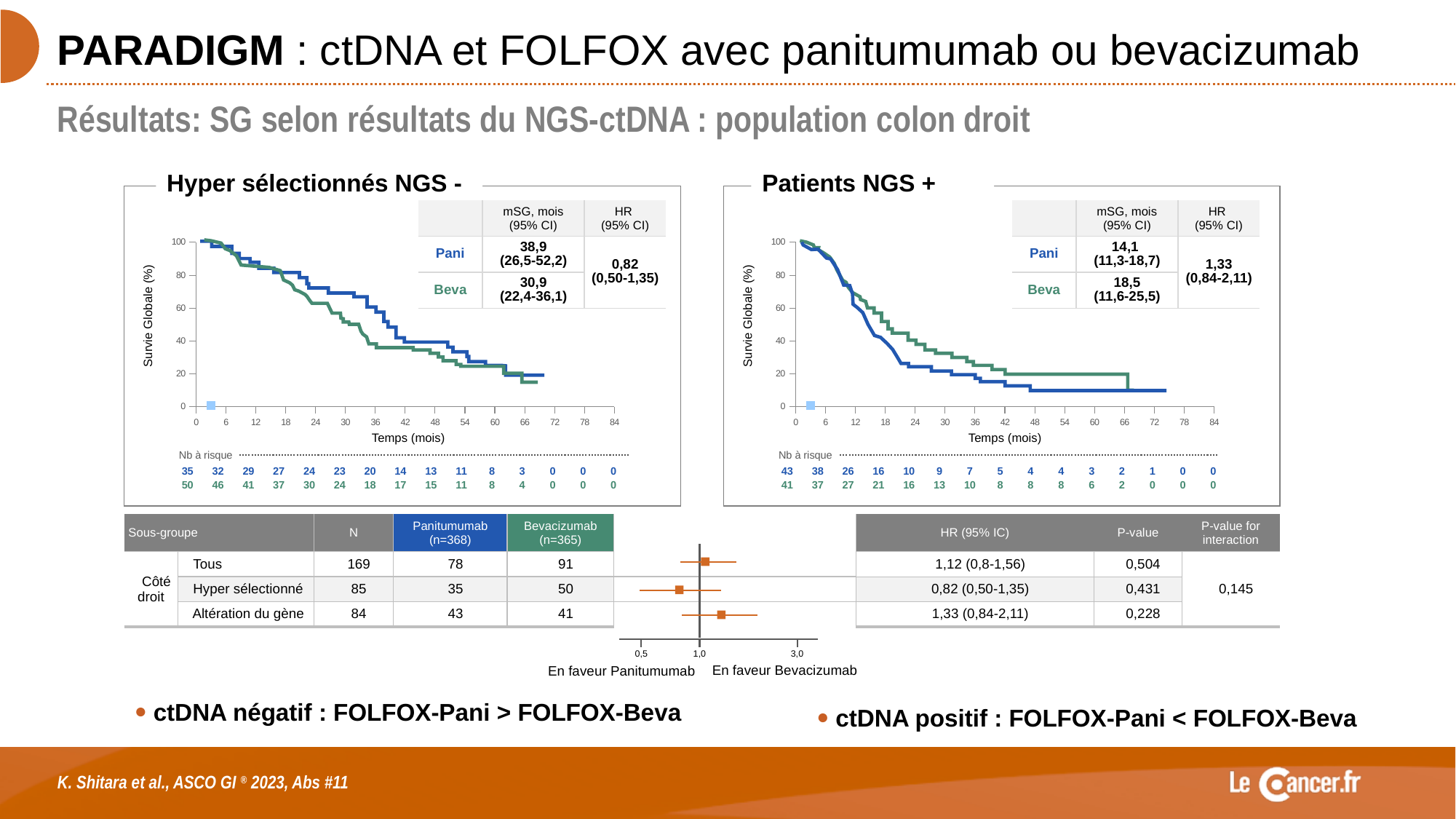
In the 'Patients NGS +' chart, what is the difference in median overall survival between Beva and Pani? 4,4 mois In the 'Hyper sélectionnés NGS -' chart, how many Pani patients are at risk at 0 months? 35 What is the x-axis label of the two survival charts? Temps (mois) In the forest plot at the bottom, how many subgroups are plotted? 3 In the 'Patients NGS +' chart, what is the median overall survival (mSG) for Beva? 18,5 mois In the 'Patients NGS +' chart, what is the HR (95% CI)? 1,33 (0,84-2,11) What kind of chart are the two upper charts on the slide? Kaplan-Meier survival curves In the 'Hyper sélectionnés NGS -' chart, which arm has the higher median overall survival, Pani or Beva? Pani In the 'Patients NGS +' chart, how many Beva patients are at risk at 24 months? 16 In the 'Hyper sélectionnés NGS -' chart, what is the median overall survival (mSG) for Pani? 38,9 mois In the forest plot table at the bottom, what is the HR (95% IC) for the 'Tous' subgroup? 1,12 (0,8-1,56) In the forest plot table at the bottom, what is the P-value for interaction? 0,145